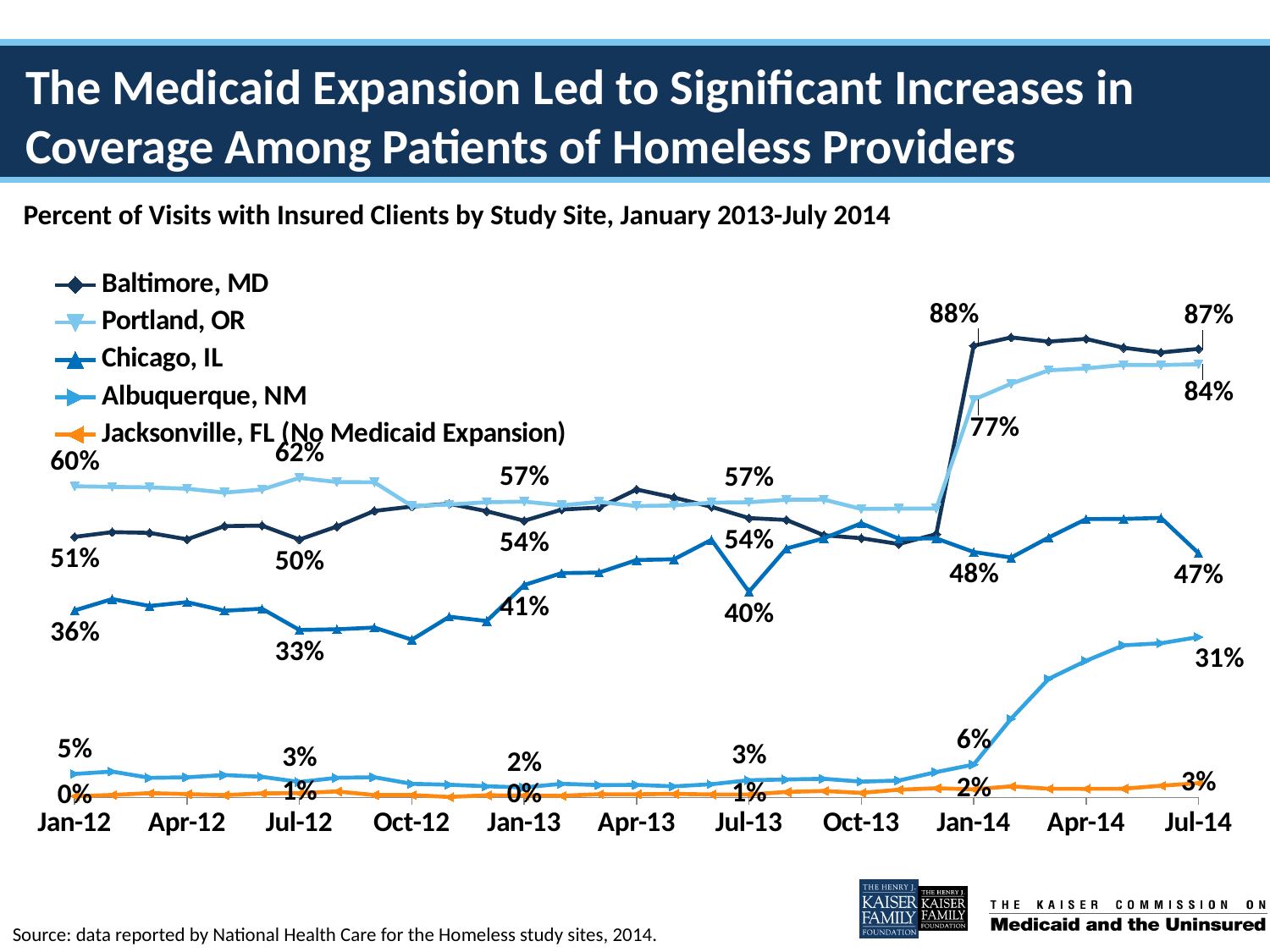
What kind of chart is shown on the slide? line chart Did the Albuquerque, NM line rise or fall between Jan-14 and Jul-14? rise Which study site had the lowest percent of visits with insured clients in Jul-14? Jacksonville, FL (No Medicaid Expansion) By how many percentage points did Baltimore, MD's value change from Jul-13 (54%) to Jan-14 (88%)? 34 percentage points What was the percent of visits with insured clients in Baltimore, MD in Jan-14? 88% What was the percent of visits with insured clients in Jacksonville, FL in Jul-14? 3% What was the percent of visits with insured clients in Albuquerque, NM in Jul-14? 31% Which study site is labeled in the legend as having no Medicaid expansion? Jacksonville, FL What was the percent of visits with insured clients in Chicago, IL in Jan-12? 36% How many study sites (series) does the legend list? 5 In Jul-14, which had the higher value: Baltimore, MD or Portland, OR? Baltimore, MD By how many percentage points did Albuquerque, NM's value increase from Jan-14 to Jul-14? 25 percentage points